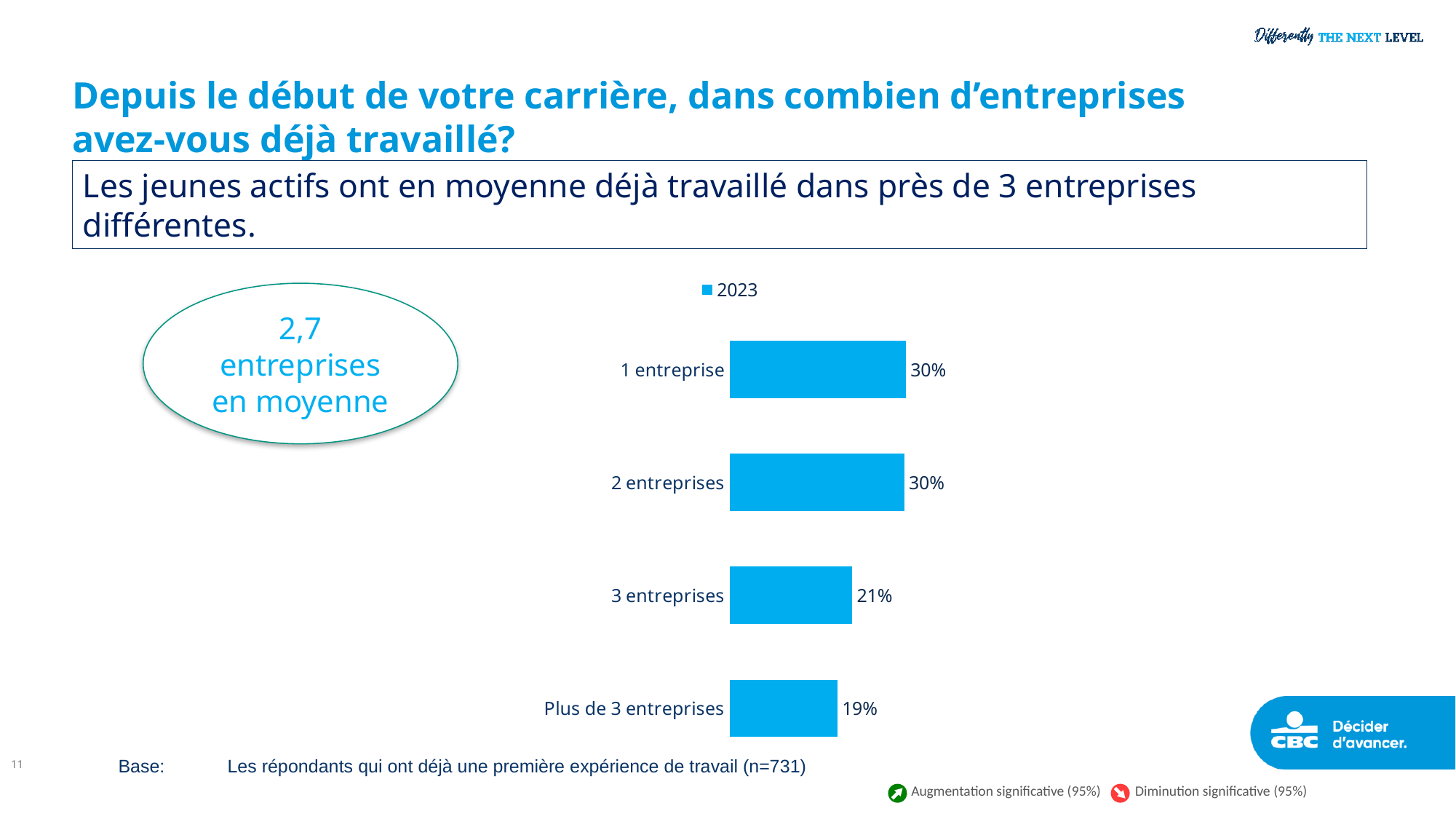
What kind of chart is shown on the slide? Bar chart Which category has the lowest value? Plus de 3 entreprises Which is larger, the value for "2 entreprises" or the value for "Plus de 3 entreprises"? 2 entreprises What is the value for "Plus de 3 entreprises"? 19% What is the difference between the values for "1 entreprise" and "3 entreprises"? 9% What is the value for "1 entreprise"? 30% How many series does the legend list? 1 What is the value for "2 entreprises"? 30% How many categories are shown in the chart? 4 What series name is shown in the chart legend? 2023 What is the difference between the values for "3 entreprises" and "Plus de 3 entreprises"? 2% What is the value for "3 entreprises"? 21%